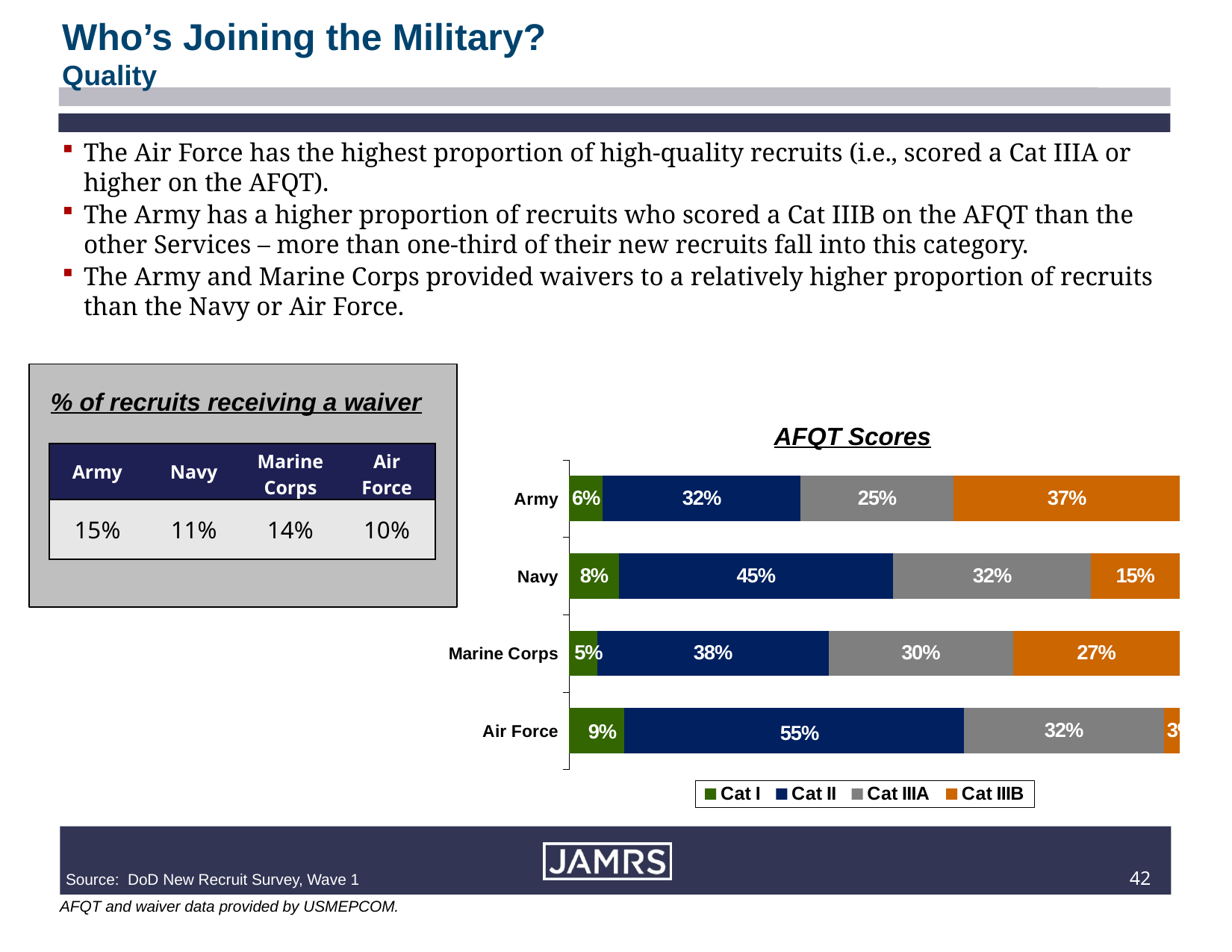
In the AFQT Scores chart, what percentage of Marine Corps recruits scored Cat I? 5% In the AFQT Scores chart, which service has the highest Cat IIIB percentage? Army In the AFQT Scores chart, which service has the lowest Cat I percentage? Marine Corps In the AFQT Scores chart, how many percentage points higher is the Navy's Cat II share than the Army's Cat II share? 13 percentage points In the AFQT Scores chart, what is the total of the Army bar's segments? 100% In the AFQT Scores chart, what percentage of Air Force recruits scored Cat II? 55% How many series does the legend of the AFQT Scores chart list? 4 In the AFQT Scores chart, which has a larger Cat IIIB share, the Navy or the Marine Corps? Marine Corps In the AFQT Scores chart, what percentage of Navy recruits scored Cat II? 45% In the AFQT Scores chart, what percentage of Army recruits scored Cat IIIB? 37% How many services are shown in the AFQT Scores chart? 4 In the AFQT Scores chart, which service has the highest Cat II percentage? Air Force